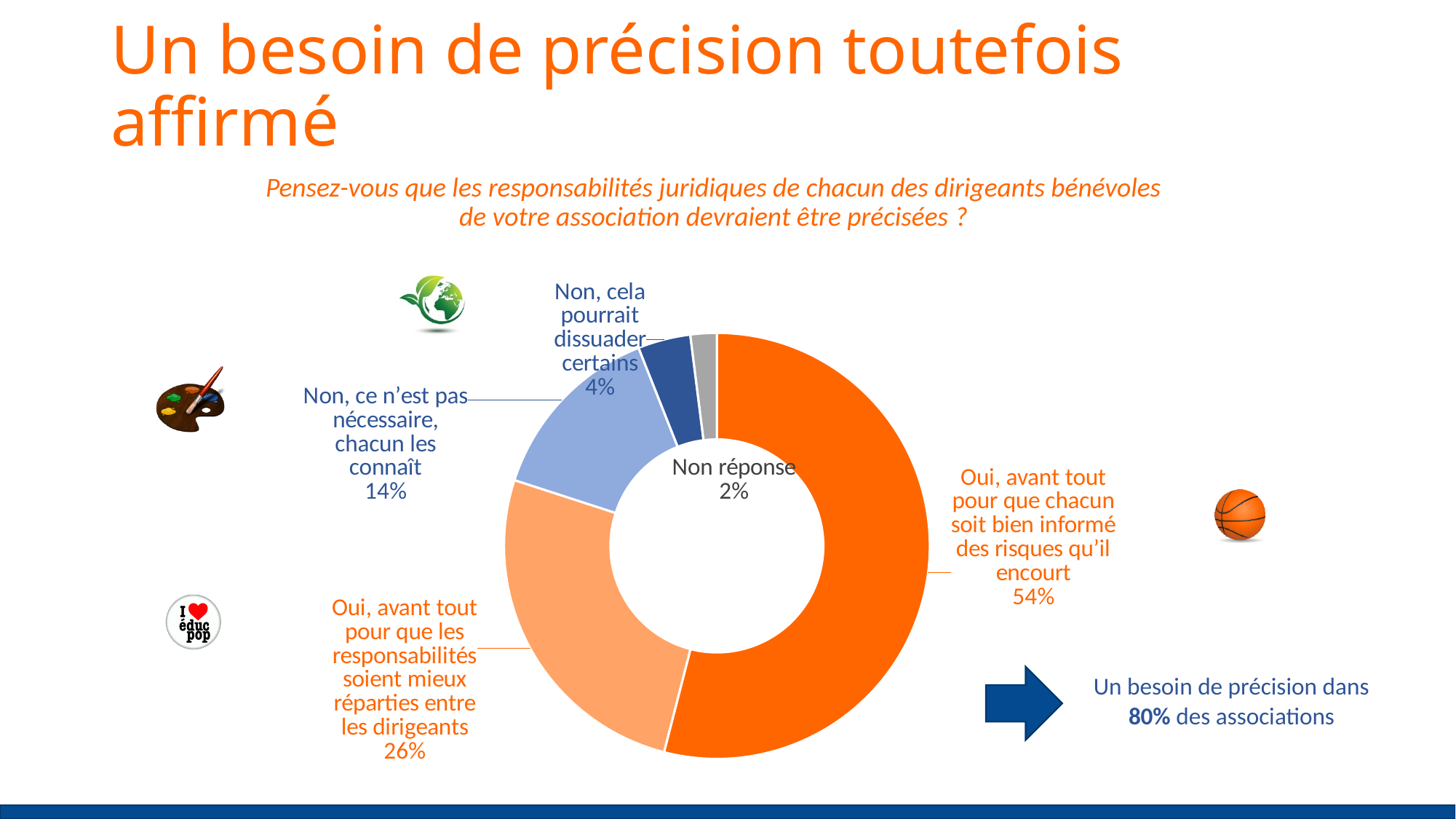
Which is larger: the share for "Non, ce n'est pas nécessaire, chacun les connaît" or the share for "Non, cela pourrait dissuader certains"? Non, ce n'est pas nécessaire, chacun les connaît What share of respondents answered "Non, cela pourrait dissuader certains"? 4% What kind of chart is shown on the slide? Doughnut (pie) chart What share of respondents answered "Oui, avant tout pour que les responsabilités soient mieux réparties entre les dirigeants"? 26% How many categories are shown in the chart? 5 What share of respondents answered "Oui, avant tout pour que chacun soit bien informé des risques qu'il encourt"? 54% Which response has the smallest share of the chart? Non réponse Which response has the largest share of the chart? Oui, avant tout pour que chacun soit bien informé des risques qu'il encourt What share of respondents gave no answer ("Non réponse")? 2% What is the difference in percentage points between the "Oui, avant tout pour que chacun soit bien informé" slice and the "Oui, avant tout pour que les responsabilités soient mieux réparties" slice? 28 percentage points What share of respondents answered "Non, ce n'est pas nécessaire, chacun les connaît"? 14% What is the combined share of the two "Oui" responses? 80%